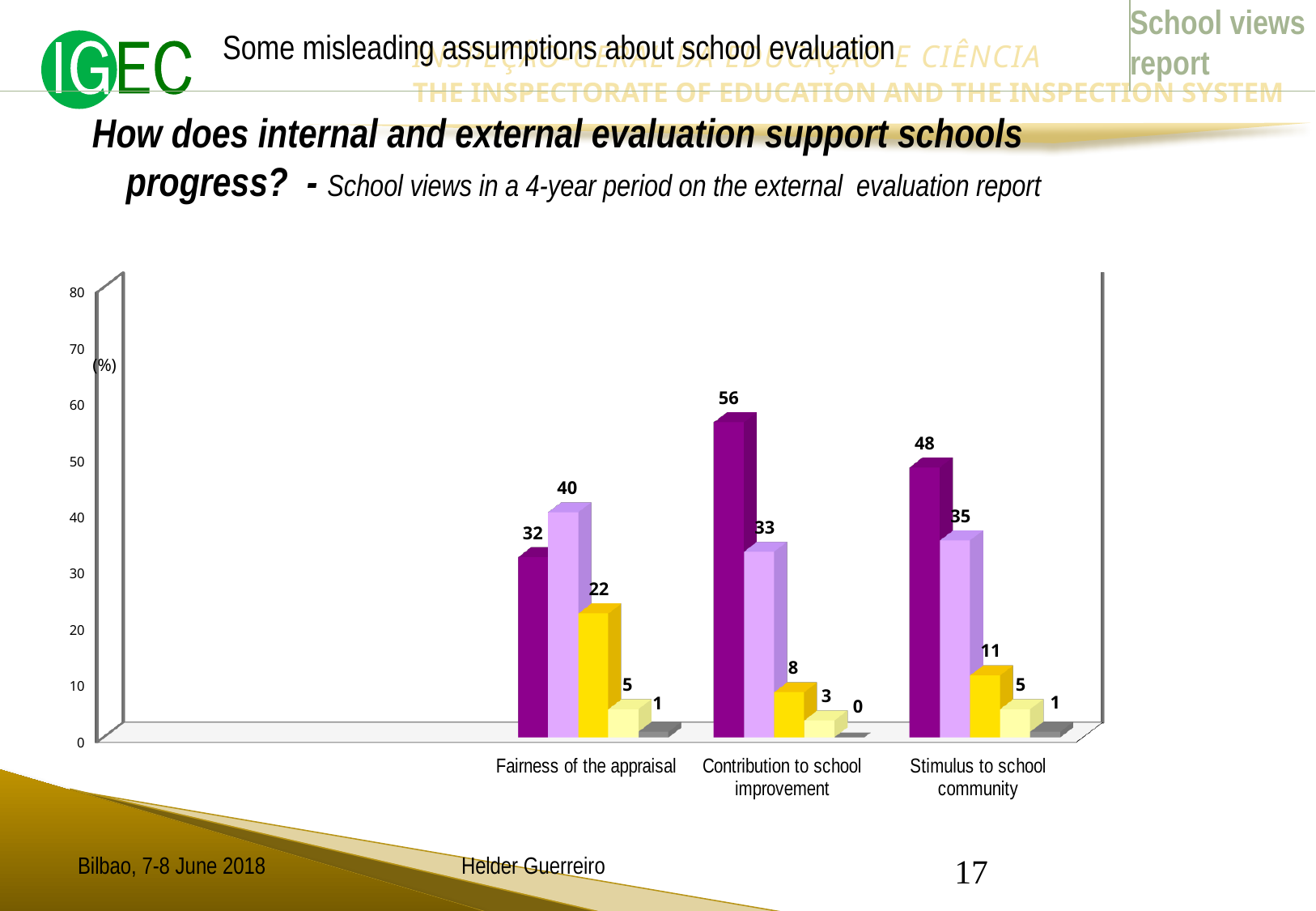
What is the value of the yellow bar for "Stimulus to school community"? 11 How many categories are shown on the x axis? 3 Is the dark purple bar for "Stimulus to school community" greater or less than 40? greater Which category has the highest dark purple bar? Contribution to school improvement Which is larger for "Fairness of the appraisal": the dark purple bar or the light purple bar? the light purple bar What kind of chart is shown on the slide? bar chart What unit is indicated on the vertical axis of the chart? (%) What is the value of the grey bar for "Contribution to school improvement"? 0 What is the value of the dark purple bar for "Contribution to school improvement"? 56 Which category has the lowest yellow bar? Contribution to school improvement What is the difference between the dark purple bars for "Contribution to school improvement" and "Fairness of the appraisal"? 24 What is the value of the light purple bar for "Fairness of the appraisal"? 40